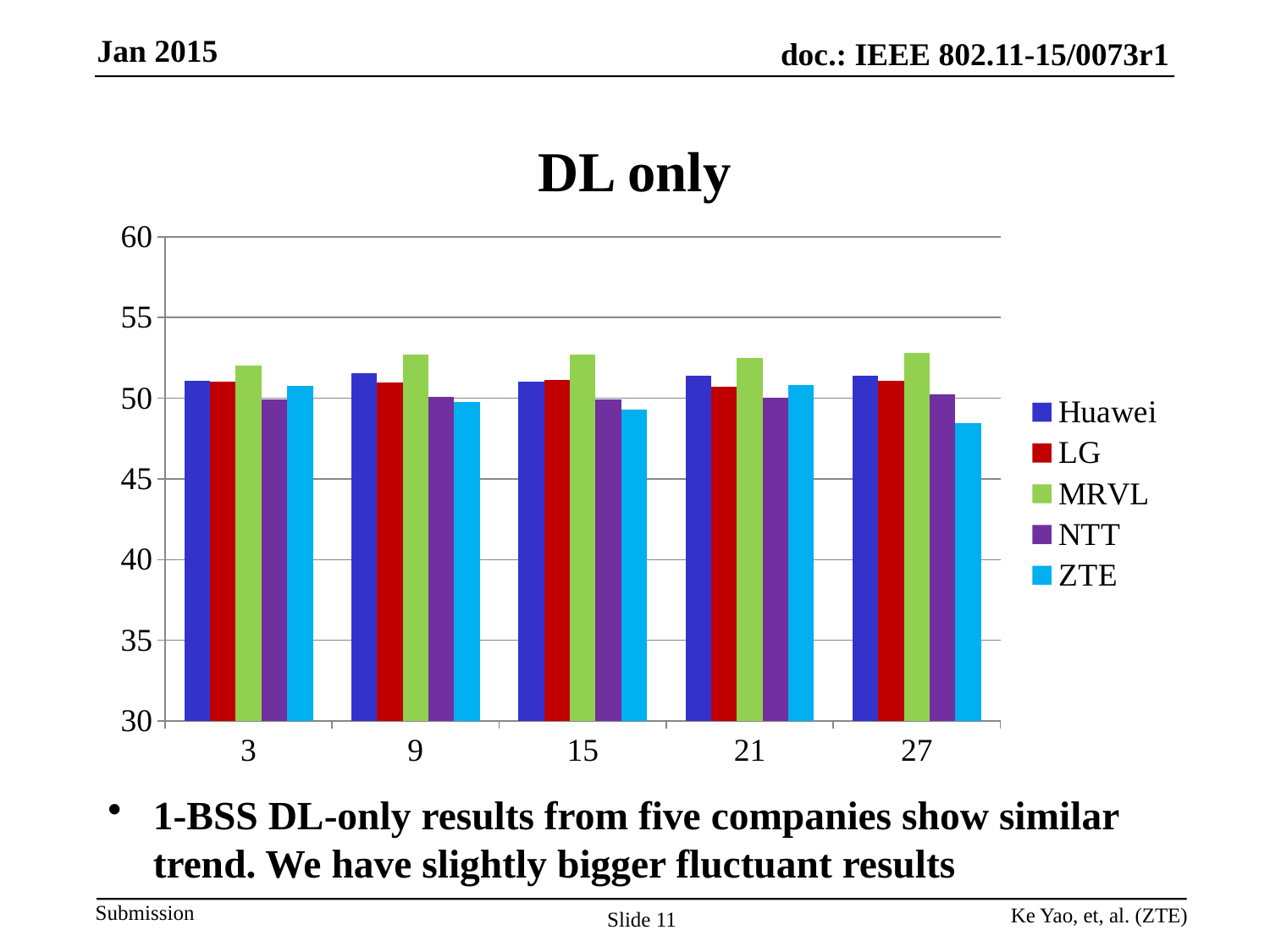
Which series has the lowest value at category 27? ZTE What kind of chart is shown on the slide? bar chart How many series does the legend list? 5 At category 27, which is larger: the value for MRVL or the value for ZTE? MRVL Is the value for ZTE at category 27 greater or less than 50? less Which series has the highest value at category 27? MRVL Which series has the highest value at category 9? MRVL Which series is represented by the green bars? MRVL Is the value for MRVL at category 15 greater or less than 50? greater What is the title of the chart? DL only How many categories are shown on the x axis? 5 At category 15, which is larger: the value for MRVL or the value for NTT? MRVL